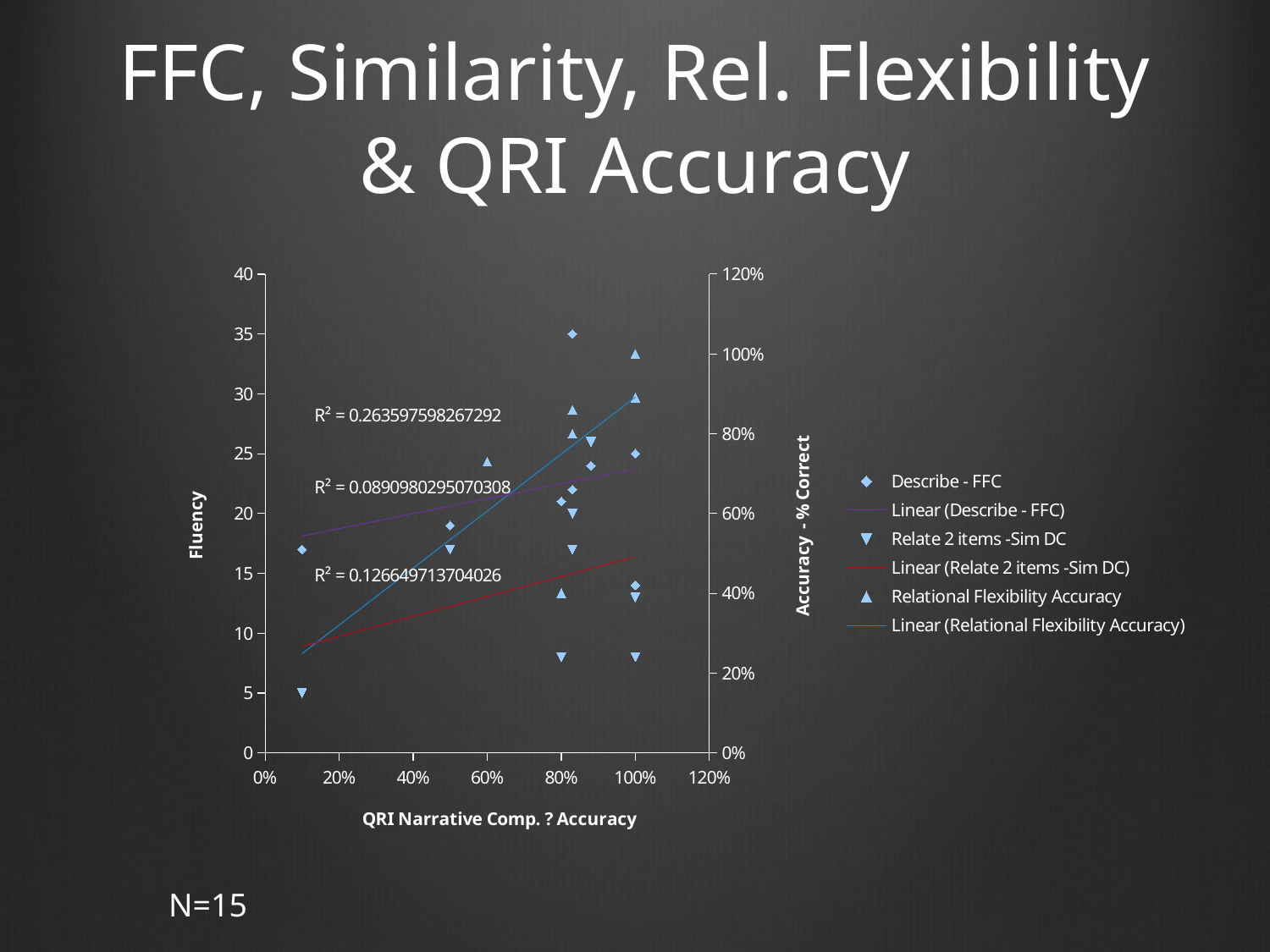
Is the highest Fluency value plotted for Describe - FFC greater or less than 30? greater What is the largest R² value printed on the chart? 0.263597598267292 Do the linear trendlines on the chart rise or fall as QRI Narrative Comp. Accuracy increases? rise How many entries does the chart legend list? 6 Is the lowest Fluency value plotted for Relate 2 items -Sim DC greater or less than 10? less Is the highest Relational Flexibility Accuracy value plotted greater or less than 80%? greater What sample size (N) is stated on the slide? N=15 What is the title of the right-hand y axis of the chart? Accuracy - % Correct What is the title of the x axis of the chart? QRI Narrative Comp. ? Accuracy What is the smallest R² value printed on the chart? 0.0890980295070308 What kind of chart is shown on the slide? scatter chart How many R² values are printed on the chart? 3